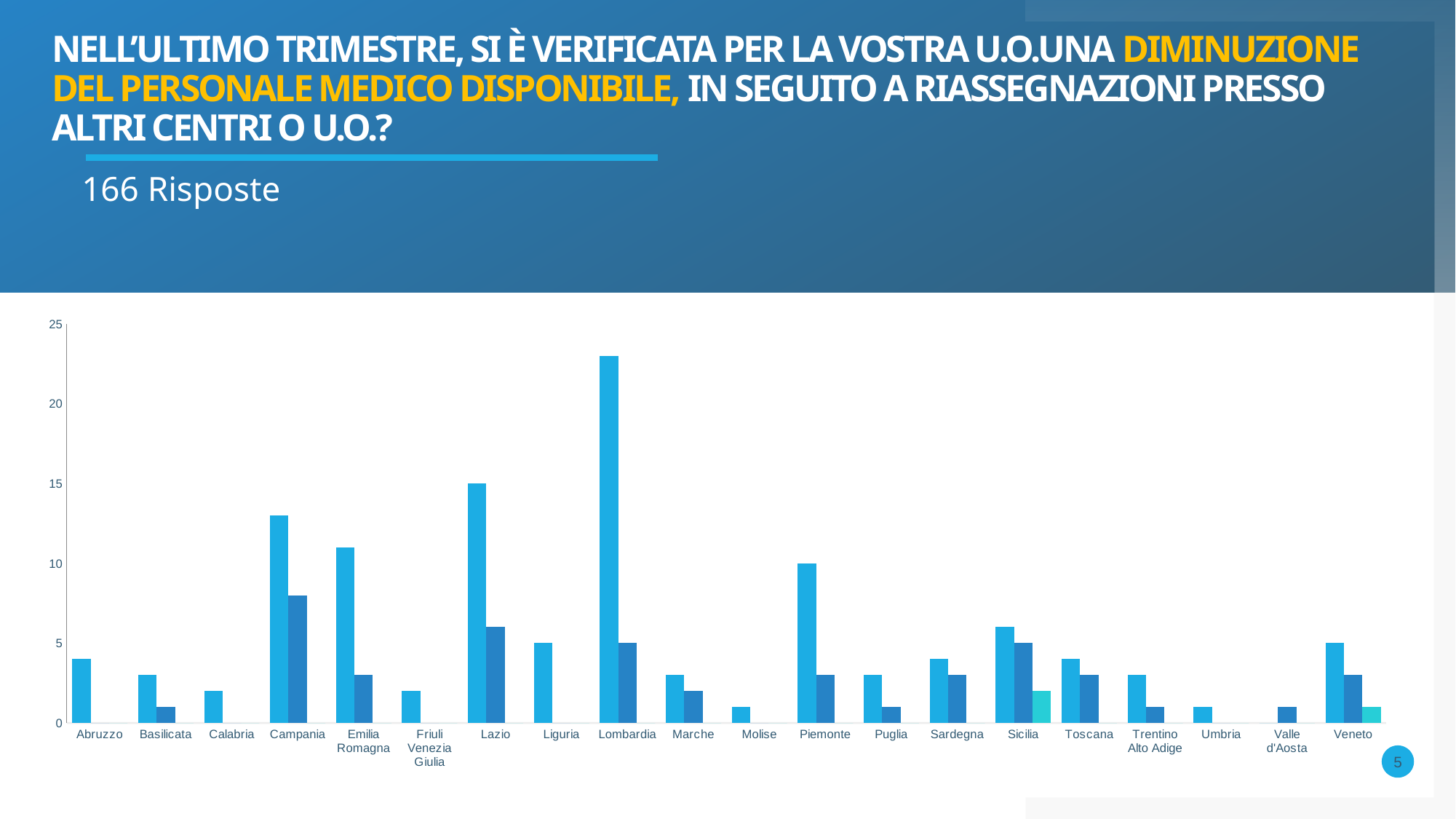
What is the value of the light blue bar for Piemonte? 10 Which has the taller light blue bar, Campania or Emilia Romagna? Campania Is the value of the light blue bar for Lombardia greater or less than 20? greater What is the value of the light blue bar for Lazio? 15 What is the value of the bar for Liguria? 5 Which region has the tallest bar in the chart? Lombardia Is the value of the dark blue bar for Campania greater or less than 5? greater How many regions (categories) are shown on the x axis of the chart? 20 What type of chart is shown on the slide? bar chart Which regions have a third, teal-coloured bar in the chart? Sicilia and Veneto Is the value of the light blue bar for Campania greater or less than 10? greater